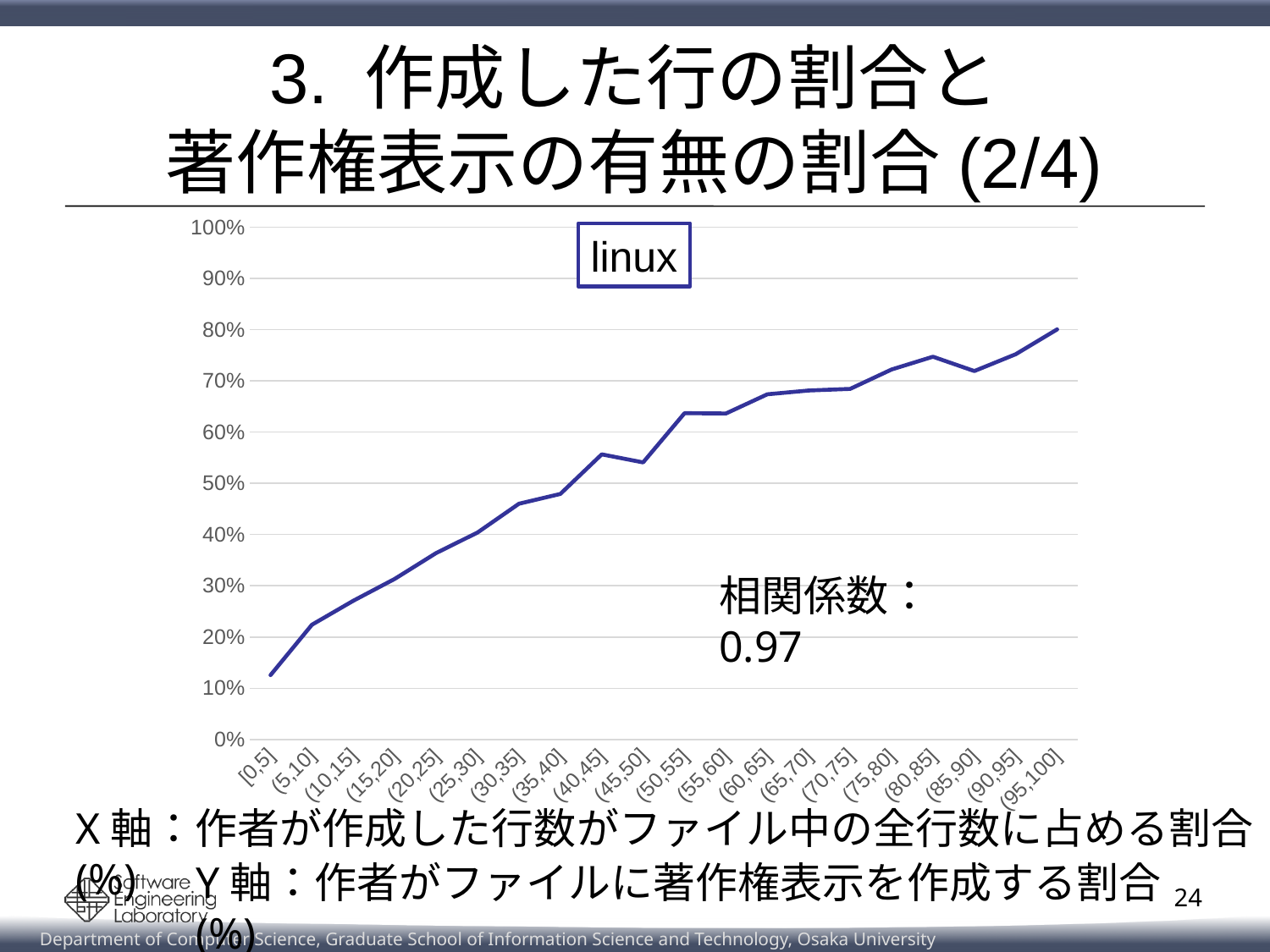
Do the values generally rise or fall as you move from [0,5] to (95,100] along the x axis? rise What kind of chart is shown on the slide? line chart Which x-axis category has the highest value on the chart? (95,100] Is the value for (80,85] greater or less than 70%? greater Is the value for [0,5] greater or less than 20%? less Which x-axis category has the lowest value on the chart? [0,5] Is the value for (95,100] greater or less than 70%? greater What correlation coefficient (相関係数) is stated on the chart? 0.97 How many x-axis categories (bins) are plotted on the chart? 20 Which has the larger value, (20,25] or (60,65]? (60,65]